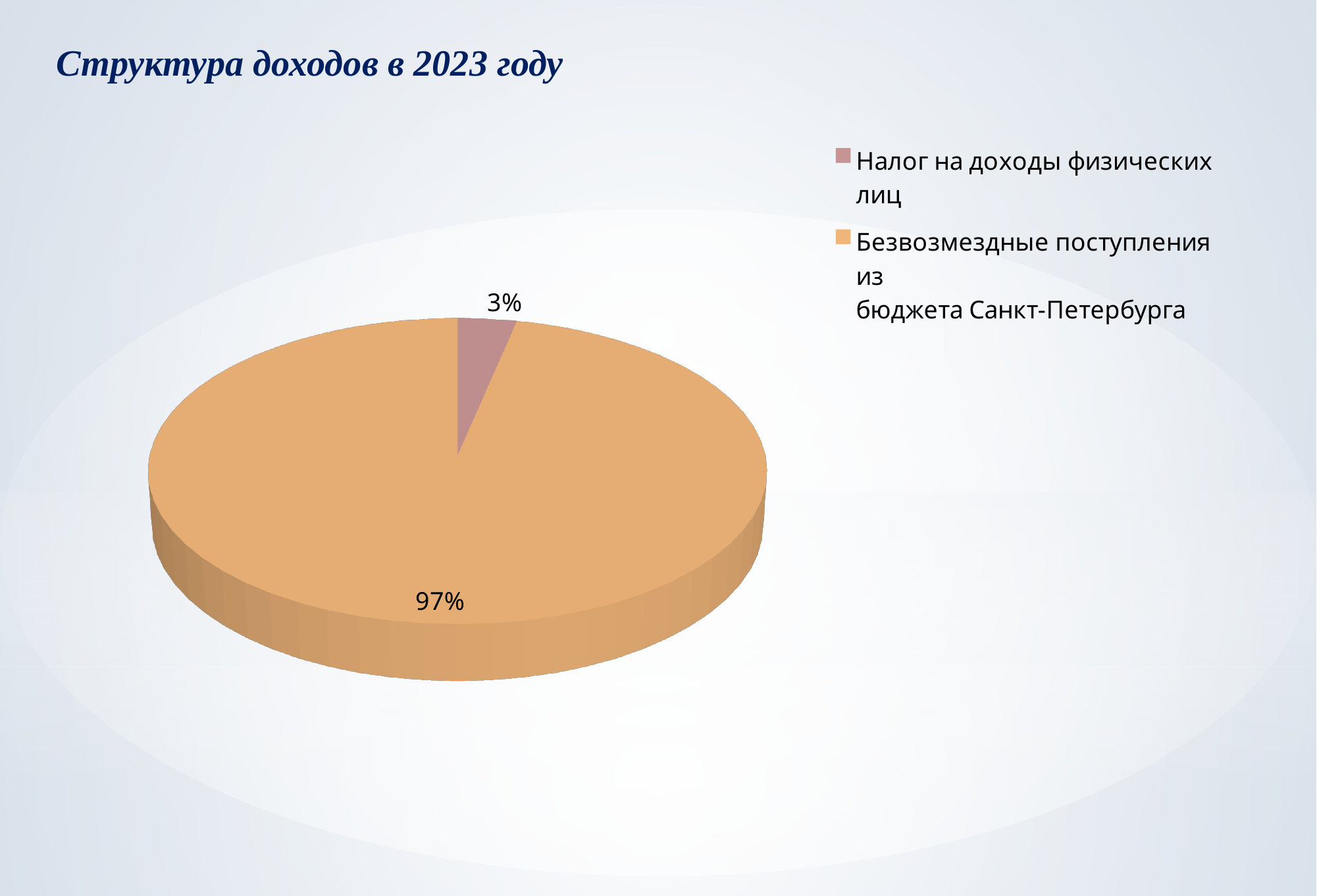
What colour is the slice for "Налог на доходы физических лиц"? Pink (mauve) Which category has the largest slice of the pie? Безвозмездные поступления из бюджета Санкт-Петербурга What is the difference in percentage points between the two slices? 94 What share of the pie does "Безвозмездные поступления из бюджета Санкт-Петербурга" take? 97% What kind of chart is shown on the slide? Pie chart Which category has the smallest slice of the pie? Налог на доходы физических лиц Which is larger: the slice for "Налог на доходы физических лиц" or the slice for "Безвозмездные поступления из бюджета Санкт-Петербурга"? Безвозмездные поступления из бюджета Санкт-Петербурга How many entries does the legend list? 2 What is the title of the slide? Структура доходов в 2023 году What share of the pie does "Налог на доходы физических лиц" take? 3% How many categories does the pie chart have? 2